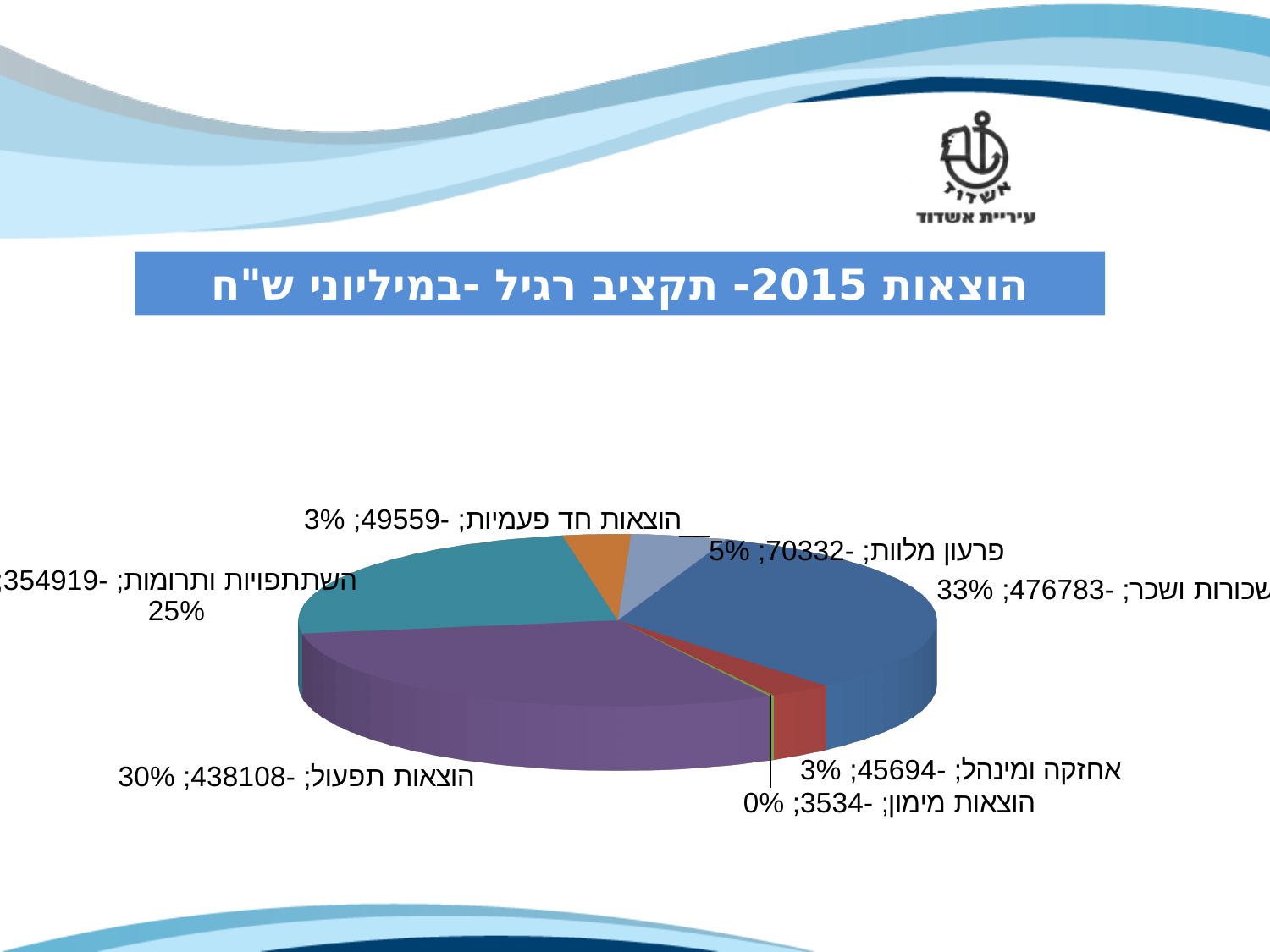
Which category has the largest slice of the pie? משכורות ושכר What value is shown for הוצאות תפעול (operating expenses)? -438108 What is the difference between the values for הוצאות תפעול (438108) and פרעון מלוות (70332)? 367776 What percentage share is shown for השתתפויות ותרומות (participations and donations)? 25% Which is larger, the value for הוצאות חד פעמיות or the value for אחזקה ומינהל? הוצאות חד פעמיות What kind of chart is shown on the slide? Pie chart What value is shown for פרעון מלוות (loan repayment)? -70332 What value is shown for הוצאות חד פעמיות (one-time expenses)? -49559 What is the title of the chart on the slide? הוצאות 2015- תקציב רגיל -במיליוני ש"ח What percentage share is shown for הוצאות תפעול (operating expenses)? 30% Which category has the smallest slice of the pie? הוצאות מימון How many slices does the pie chart have? 7